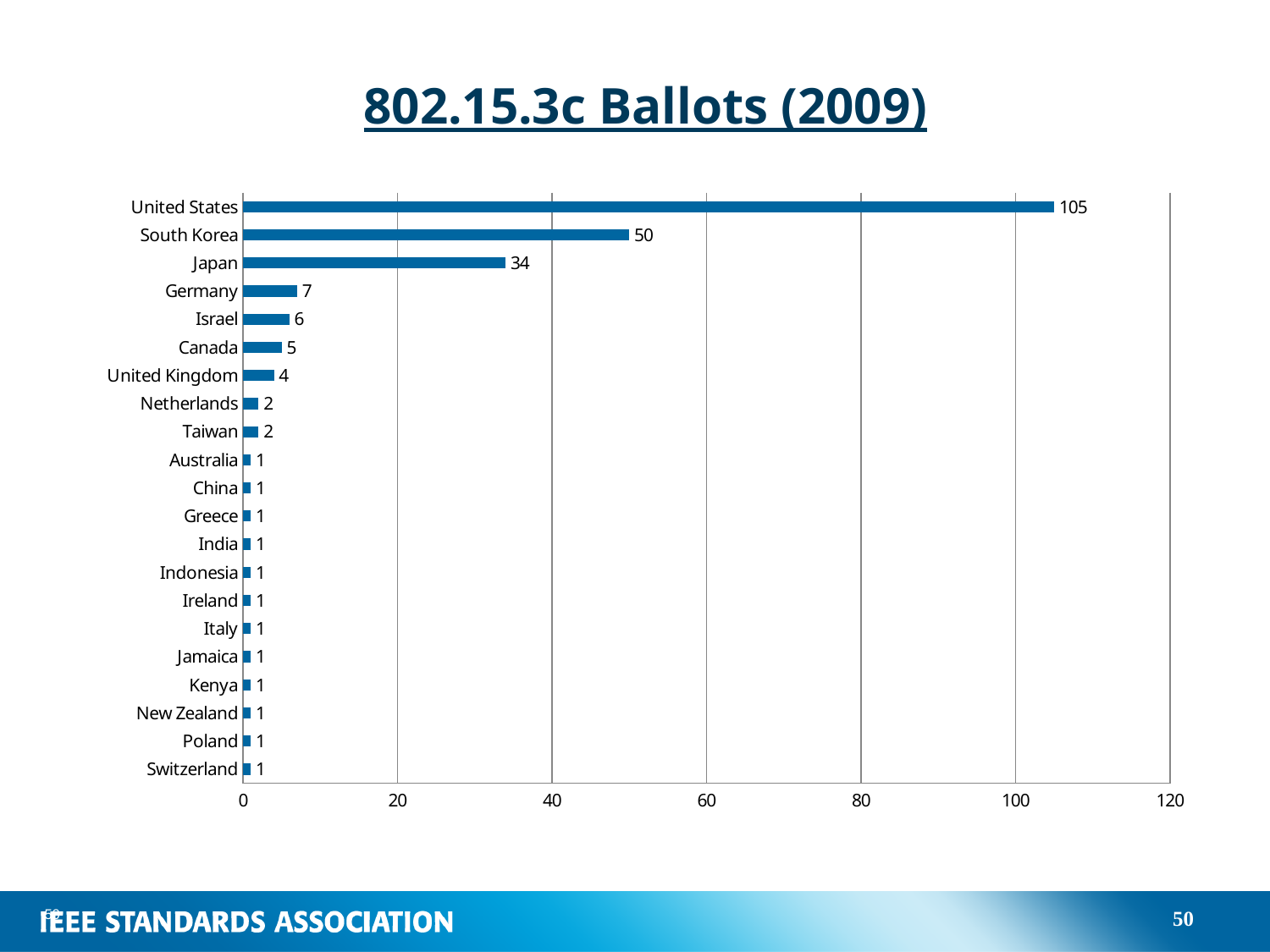
What is the title of the chart? 802.15.3c Ballots (2009) Is the value for the United States greater or less than 100? greater What is the difference between the values for South Korea and Japan? 16 Which has a larger value, Israel or Canada? Israel What is the value for Germany? 7 What is the value for Japan? 34 Which country has the highest number of ballots? United States How many ballots does the chart show for the United States? 105 What kind of chart is shown on the slide? Bar chart What is the value for the United Kingdom? 4 How many countries are listed in the chart? 21 What is the difference between the values for the United States and South Korea? 55